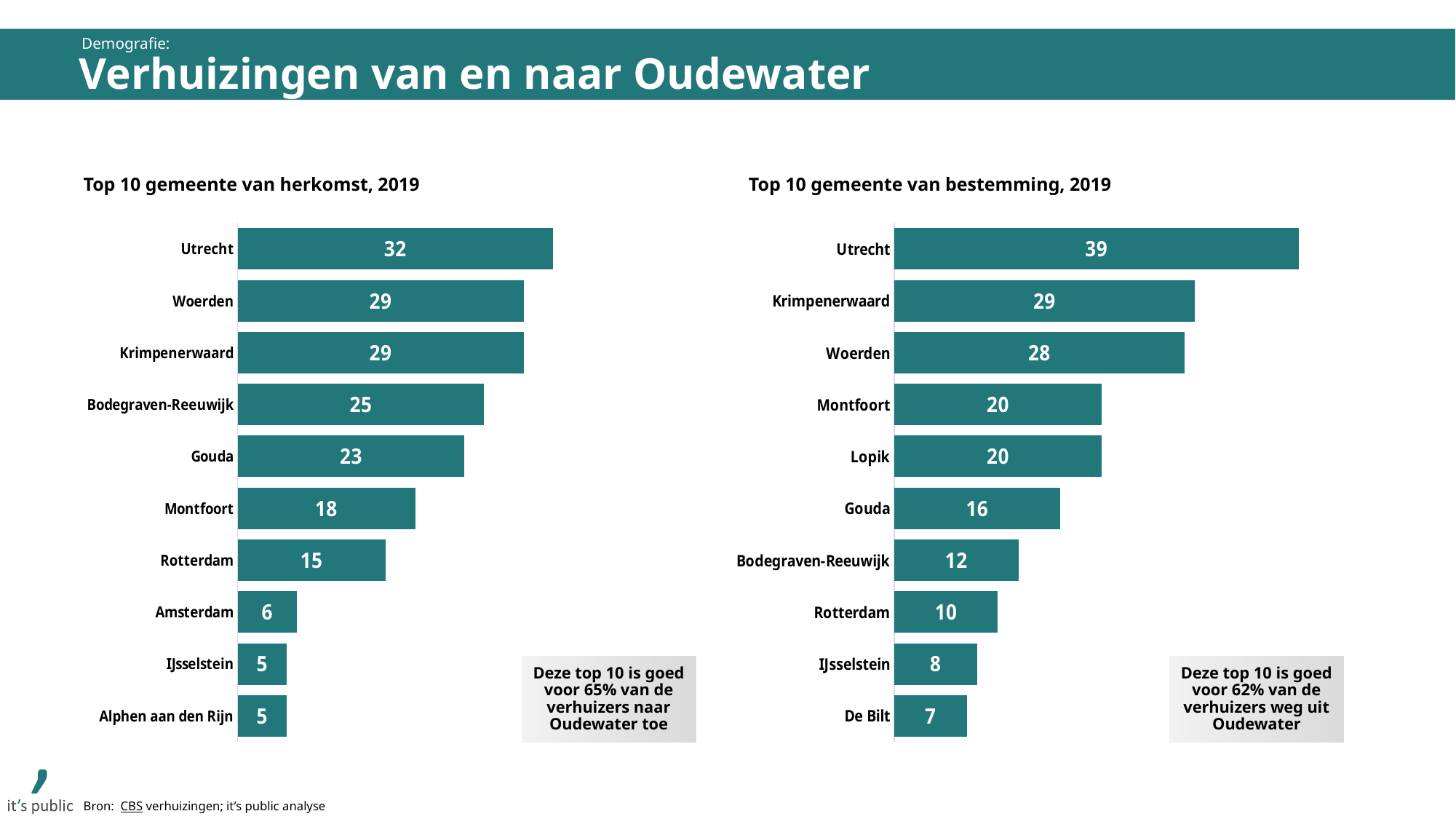
In the chart 'Top 10 gemeente van herkomst, 2019', what is the difference between the values for Utrecht and Rotterdam? 17 According to the text box next to the chart 'Top 10 gemeente van herkomst, 2019', what share of the verhuizers naar Oudewater toe does this top 10 account for? 65% In the chart 'Top 10 gemeente van bestemming, 2019', which is larger: the value for Gouda or the value for Bodegraven-Reeuwijk? Gouda In the chart 'Top 10 gemeente van herkomst, 2019', which gemeente has the highest value? Utrecht In the chart 'Top 10 gemeente van herkomst, 2019', what is the value for Gouda? 23 In the chart 'Top 10 gemeente van bestemming, 2019', which gemeente has the lowest value? De Bilt What kind of chart is 'Top 10 gemeente van bestemming, 2019'? Bar chart In the chart 'Top 10 gemeente van herkomst, 2019', what is the value for Amsterdam? 6 In the chart 'Top 10 gemeente van bestemming, 2019', what is the difference between the values for Utrecht and Krimpenerwaard? 10 In the chart 'Top 10 gemeente van herkomst, 2019', how many gemeenten are shown? 10 In the chart 'Top 10 gemeente van bestemming, 2019', what is the value for Montfoort? 20 In the chart 'Top 10 gemeente van bestemming, 2019', what is the value for Rotterdam? 10